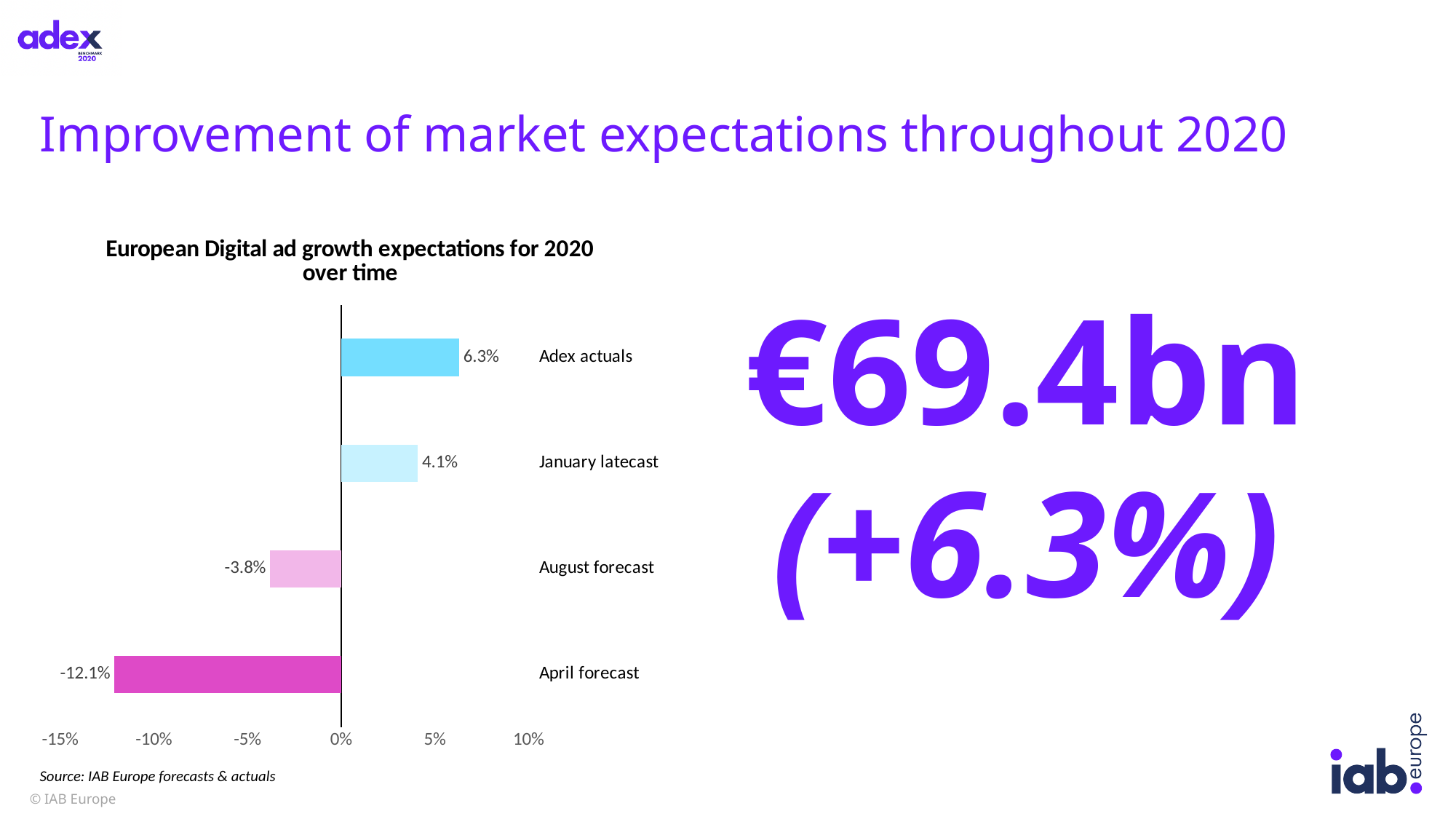
What kind of chart is shown on the slide? Bar chart What is the value for the April forecast? -12.1% Which is larger, the August forecast or the January latecast? January latecast What is the difference between the April forecast value and the August forecast value? 8.3% What is the value for the August forecast? -3.8% What is the title of the chart? European Digital ad growth expectations for 2020 over time Which category has the highest value? Adex actuals How many categories are shown in the chart? 4 What is the value for the January latecast? 4.1% What is the difference between the Adex actuals value and the January latecast value? 2.2% Which category has the lowest value? April forecast What is the value for Adex actuals? 6.3%